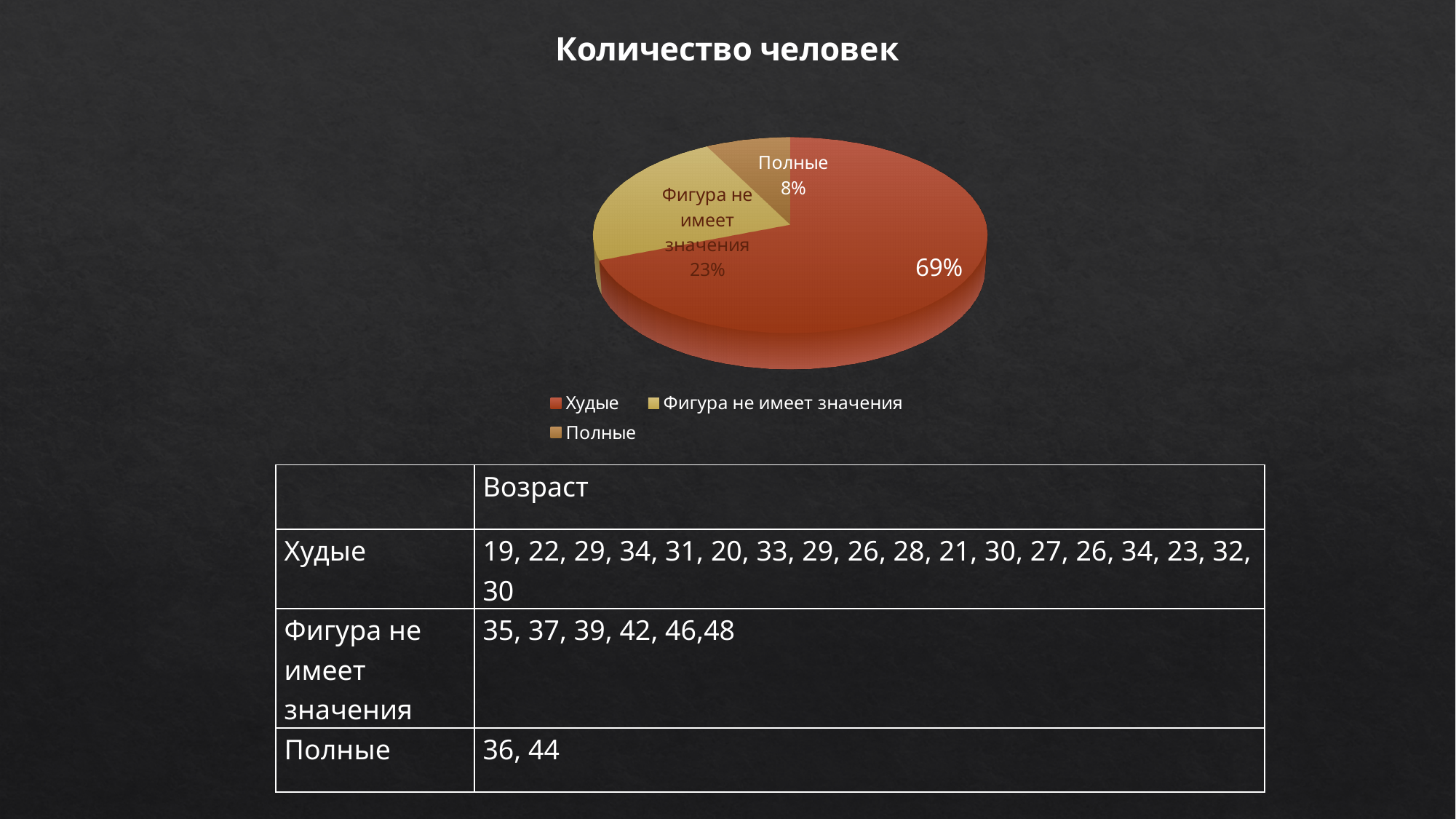
How many slices does the pie chart have? 3 What is the difference in percentage points between the "Фигура не имеет значения" and "Полные" slices? 15 What percentage of the pie does the "Худые" slice represent? 69% What kind of chart is shown on the slide? Pie chart What is the difference in percentage points between the "Худые" and "Фигура не имеет значения" slices? 46 Which slice is larger, "Фигура не имеет значения" or "Полные"? Фигура не имеет значения How many entries does the legend list? 3 Which category has the largest share of the pie? Худые What is the title of the chart? Количество человек What percentage of the pie does the "Фигура не имеет значения" slice represent? 23% What percentage of the pie does the "Полные" slice represent? 8% Which category has the smallest share of the pie? Полные